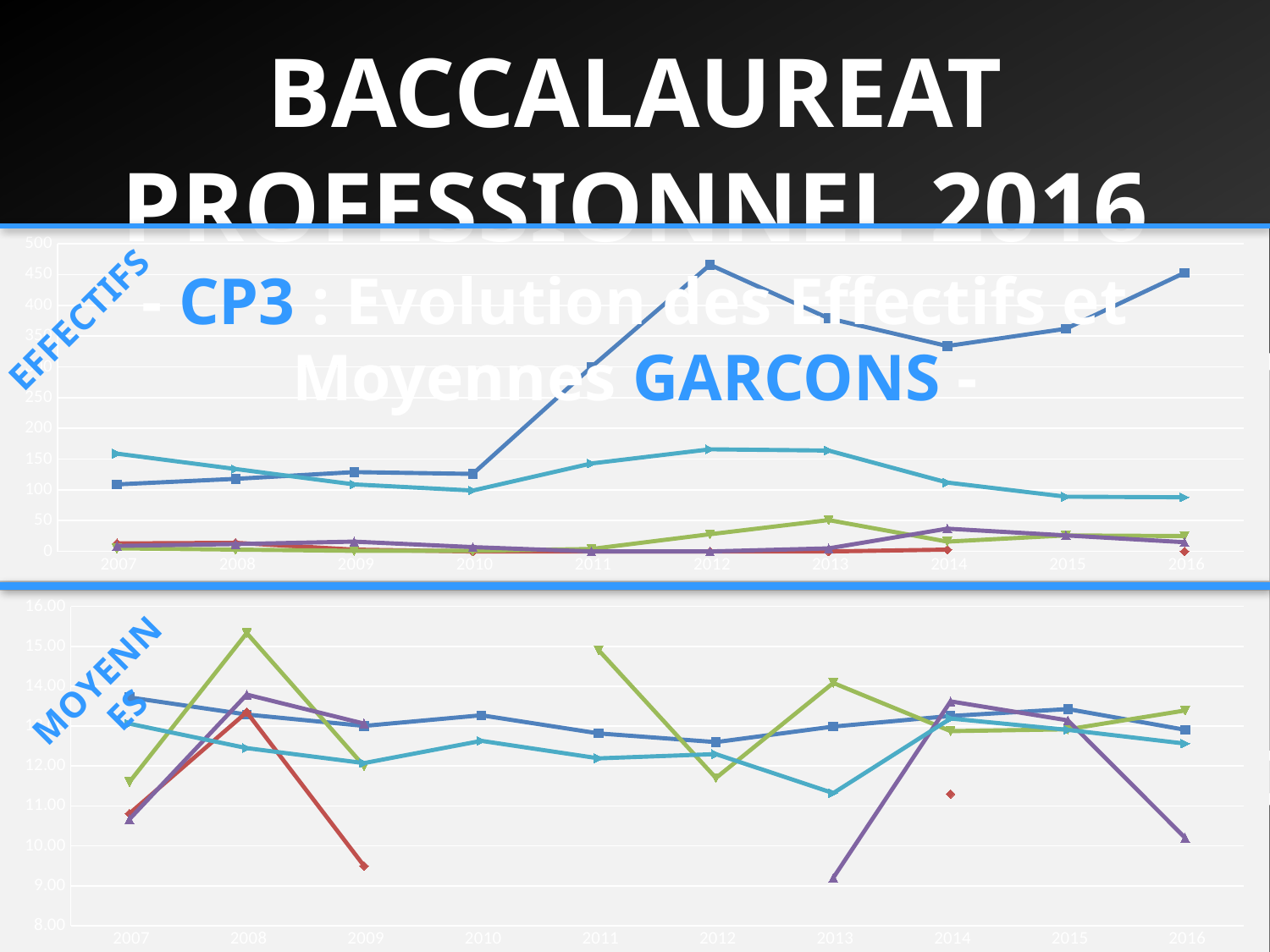
In the bottom chart (MOYENNES), in which year does the green line reach its highest value? 2008 In the top chart (EFFECTIFS), is the value of the dark blue line in 2012 greater or less than 400? greater In the top chart (EFFECTIFS), does the dark blue line rise or fall between 2010 and 2012? rises What type of chart is the top chart (EFFECTIFS)? line chart What is the highest value shown on the y axis of the top chart (EFFECTIFS)? 500 In the bottom chart (MOYENNES), is the value of the red line in 2009 greater or less than 10.00? less How many years are shown on the x axis of the bottom chart (MOYENNES)? 10 In the top chart (EFFECTIFS), is the value of the teal line in 2016 greater or less than 100? less In the top chart (EFFECTIFS), does the teal line rise or fall between 2013 and 2015? falls In the top chart (EFFECTIFS), which line is higher in 2016, the dark blue line or the teal line? the dark blue line In the top chart (EFFECTIFS), in which year does the dark blue line reach its highest value? 2012 In the bottom chart (MOYENNES), which line is higher in 2016, the purple line or the dark blue line? the dark blue line